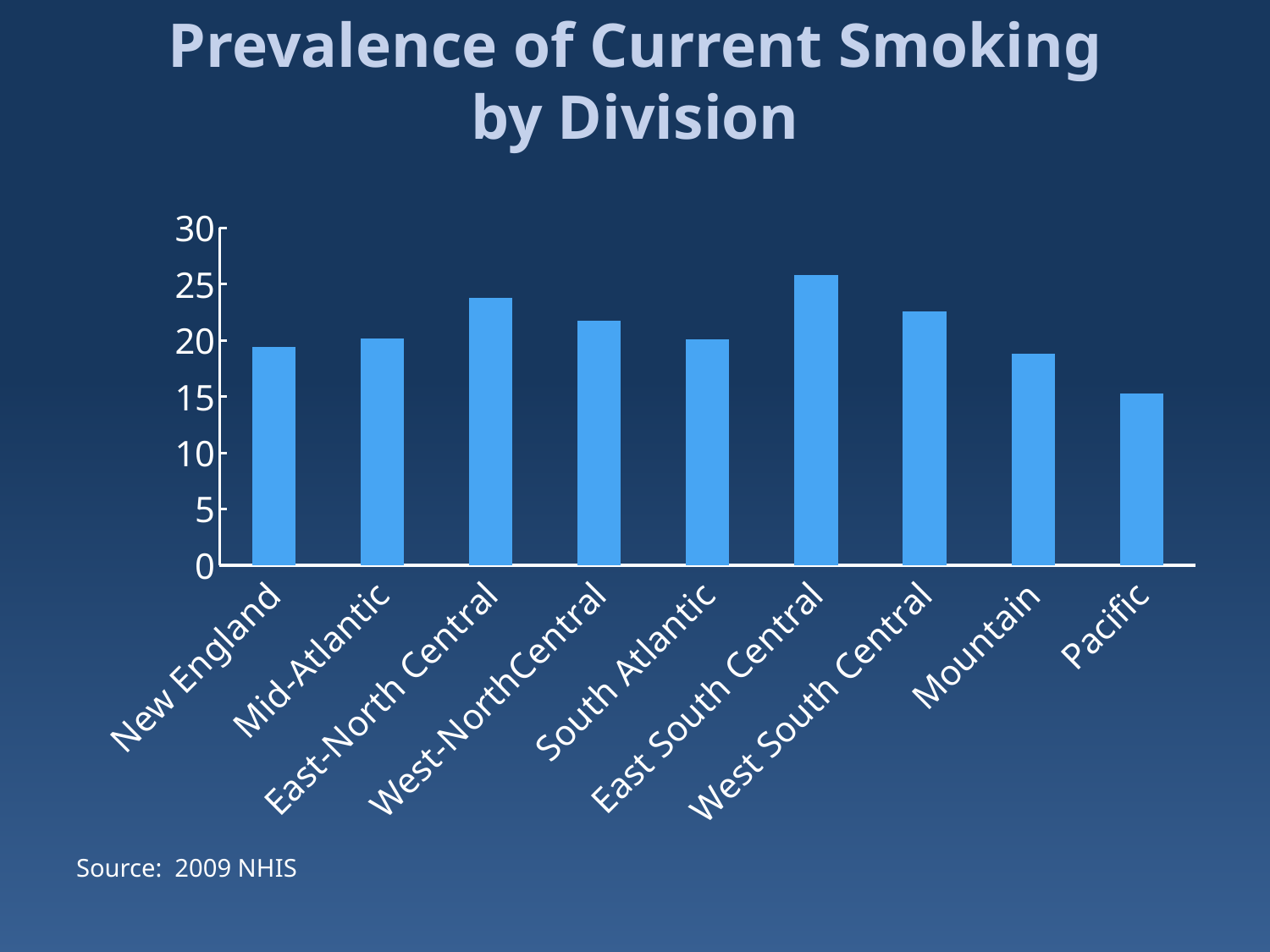
Is the value for East-North Central greater or less than 20? greater What is the title of the chart? Prevalence of Current Smoking by Division Which division has the lowest prevalence of current smoking? Pacific Which division has the highest prevalence of current smoking? East South Central What kind of chart is shown on the slide? bar chart How many divisions are shown on the x axis of the chart? 9 What source is cited for the chart data? 2009 NHIS Is the value for Pacific greater or less than 20? less Is the value for East South Central greater or less than 20? greater Which is larger, the value for West South Central or the value for New England? West South Central Which is larger, the value for East-North Central or the value for Mountain? East-North Central